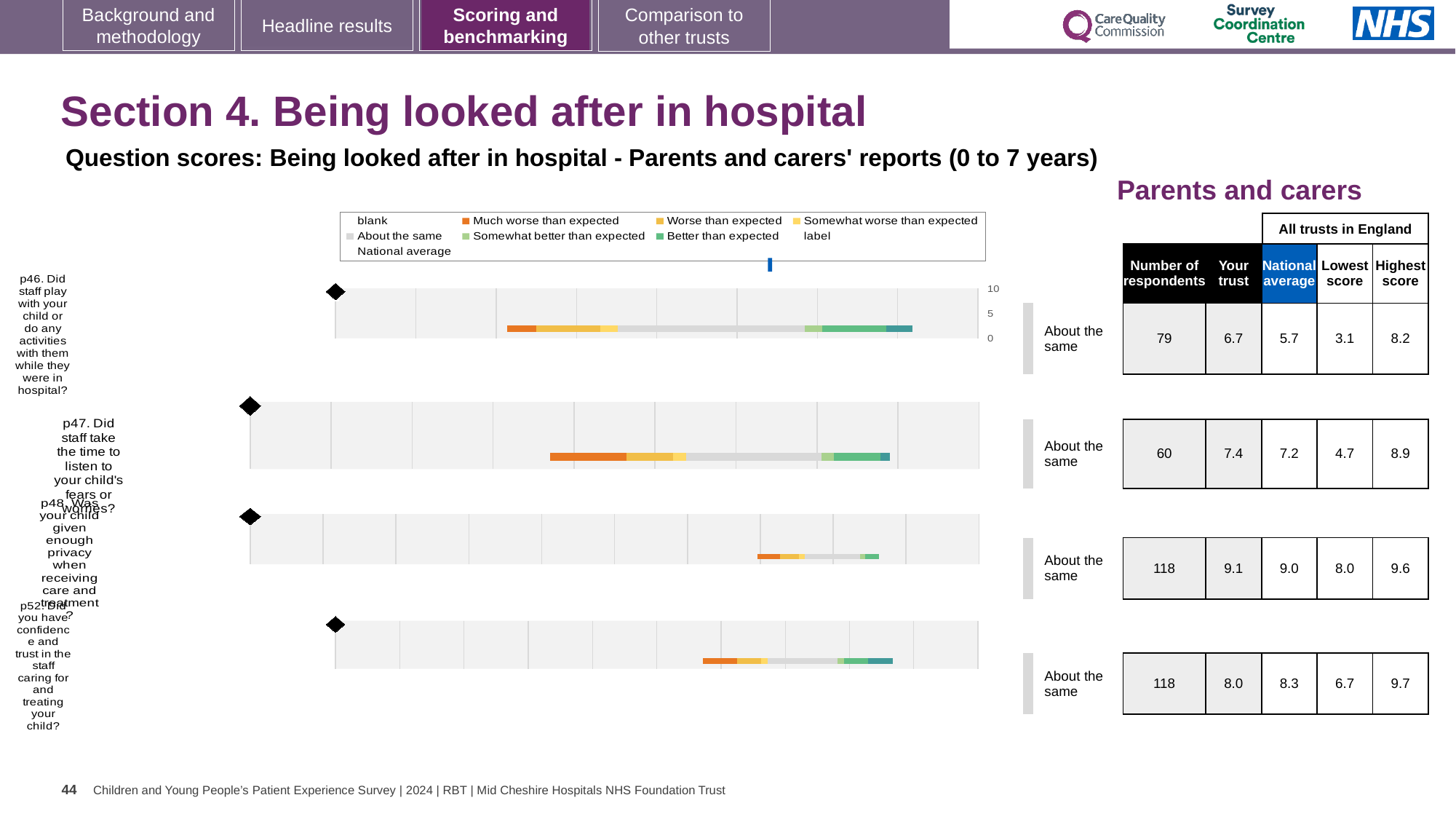
Which question has the lowest 'Your trust' score? p46 What benchmark category is shown for p46? About the same What is the number of respondents for p46 (Did staff play with your child or do any activities with them while they were in hospital?)? 79 What is the national average score for p48 (Was your child given enough privacy when receiving care and treatment?)? 9.0 What is the 'Your trust' score for p47 (Did staff take the time to listen to your child's fears or worries?)? 7.4 How many entries does the chart legend list? 9 What colour represents 'Much worse than expected' in the legend? Orange What is the difference between the highest score and the lowest score across all trusts in England for p47? 4.2 For p52 (Did you have confidence and trust in the staff caring for and treating your child?), is the 'Your trust' score higher or lower than the national average? Lower How many survey questions (p46, p47, p48, p52) are plotted on the slide? 4 What kind of chart is used to show the question scores for Being looked after in hospital? Bar chart Which question has the highest 'Your trust' score? p48